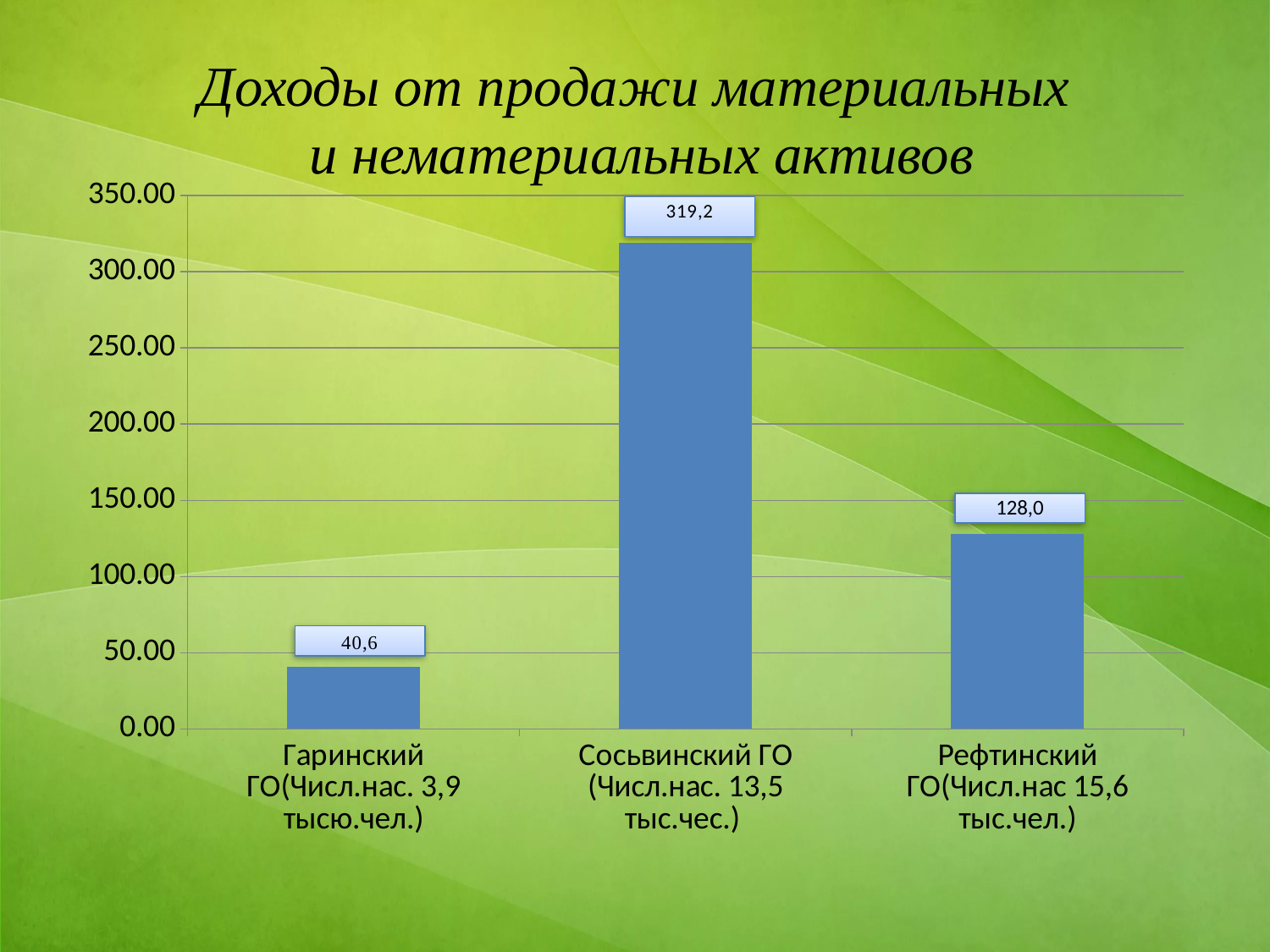
What is the value for Рефтинский ГО? 128,0 What is the difference between the values for Рефтинский ГО and Гаринский ГО? 87,4 Which category has the highest value? Сосьвинский ГО Which category has the lowest value? Гаринский ГО What is the value for Гаринский ГО? 40,6 What is the value for Сосьвинский ГО? 319,2 Which is larger, the value for Рефтинский ГО or the value for Гаринский ГО? Рефтинский ГО What is the difference between the values for Сосьвинский ГО and Рефтинский ГО? 191,2 Is the value for Сосьвинский ГО greater or less than 300? greater What kind of chart is shown on the slide? bar chart How many categories are shown on the chart? 3 What is the title of the chart? Доходы от продажи материальных и нематериальных активов